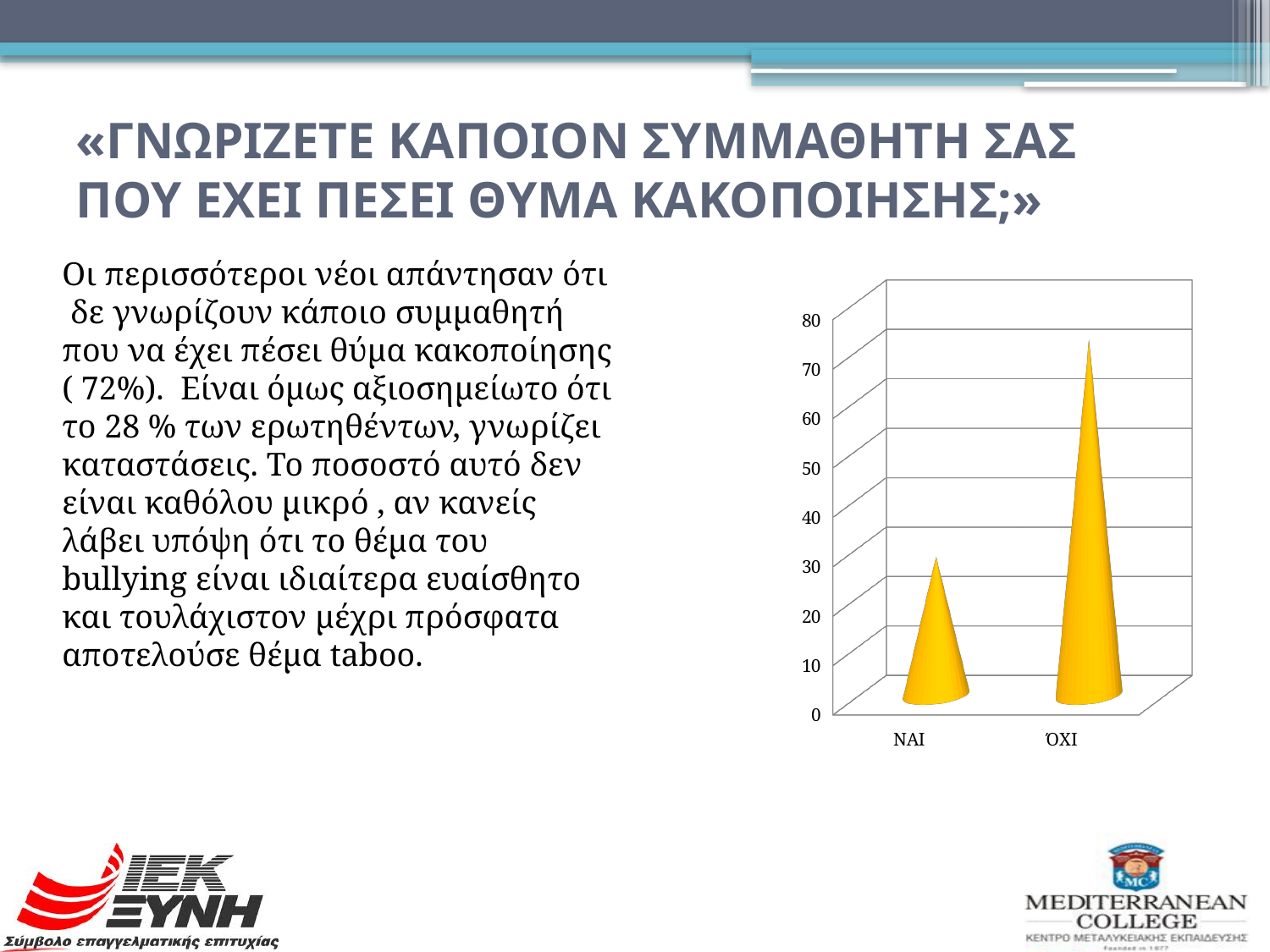
What are the two category labels on the x axis of the chart? ΝΑΙ and ΌΧΙ Which is larger, the value for ΝΑΙ or the value for ΌΧΙ? ΌΧΙ Is the value for ΌΧΙ greater or less than 80? less Which category has the lowest value on the chart? ΝΑΙ What is the highest value shown on the chart's vertical axis? 80 What kind of chart is shown on the slide? bar chart Is the value for ΝΑΙ greater or less than 40? less How many categories are plotted on the chart? 2 Is the value for ΌΧΙ greater or less than 60? greater Which category has the highest value on the chart? ΌΧΙ